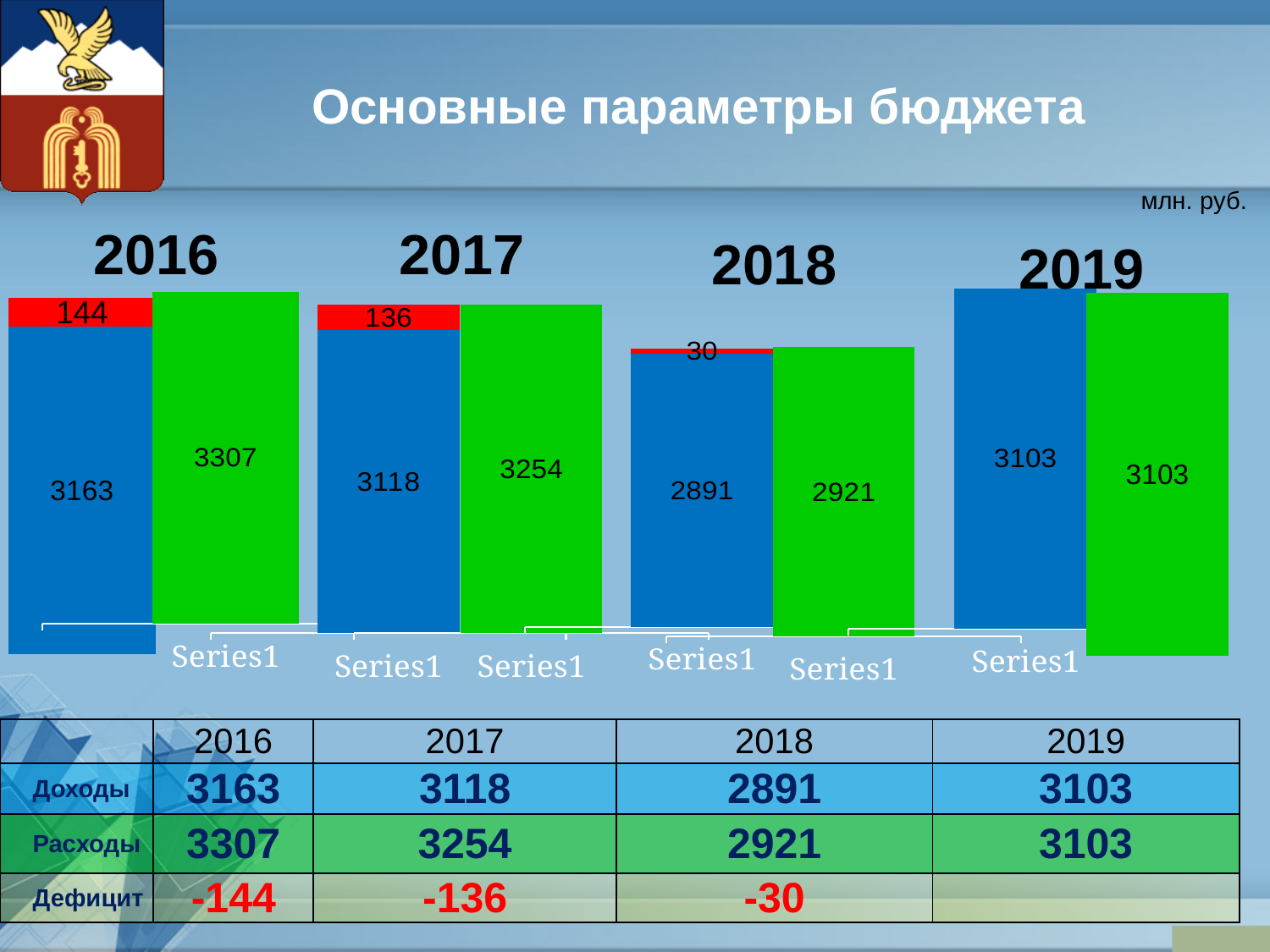
What is the difference between Доходы in 2016 (3163) and Доходы in 2017 (3118)? 45 Which year has the lowest Доходы (income) value? 2018 How many years are shown on the chart? 4 Which year has the highest Расходы (expenses) value? 2016 What is the deficit value shown in red for 2018? 30 Do the Доходы (income) values rise or fall from 2016 to 2018? Fall What kind of chart is shown on the slide? Bar chart What is the value of Доходы (income) for 2016 on the chart? 3163 What unit of measurement is indicated on the slide for the chart values? млн. руб. What is the value of Расходы (expenses) for 2017 on the chart? 3254 What is the total of the stacked blue and red bar for 2016 (3163 + 144)? 3307 Which is larger: Расходы in 2017 or Расходы in 2018? Расходы in 2017